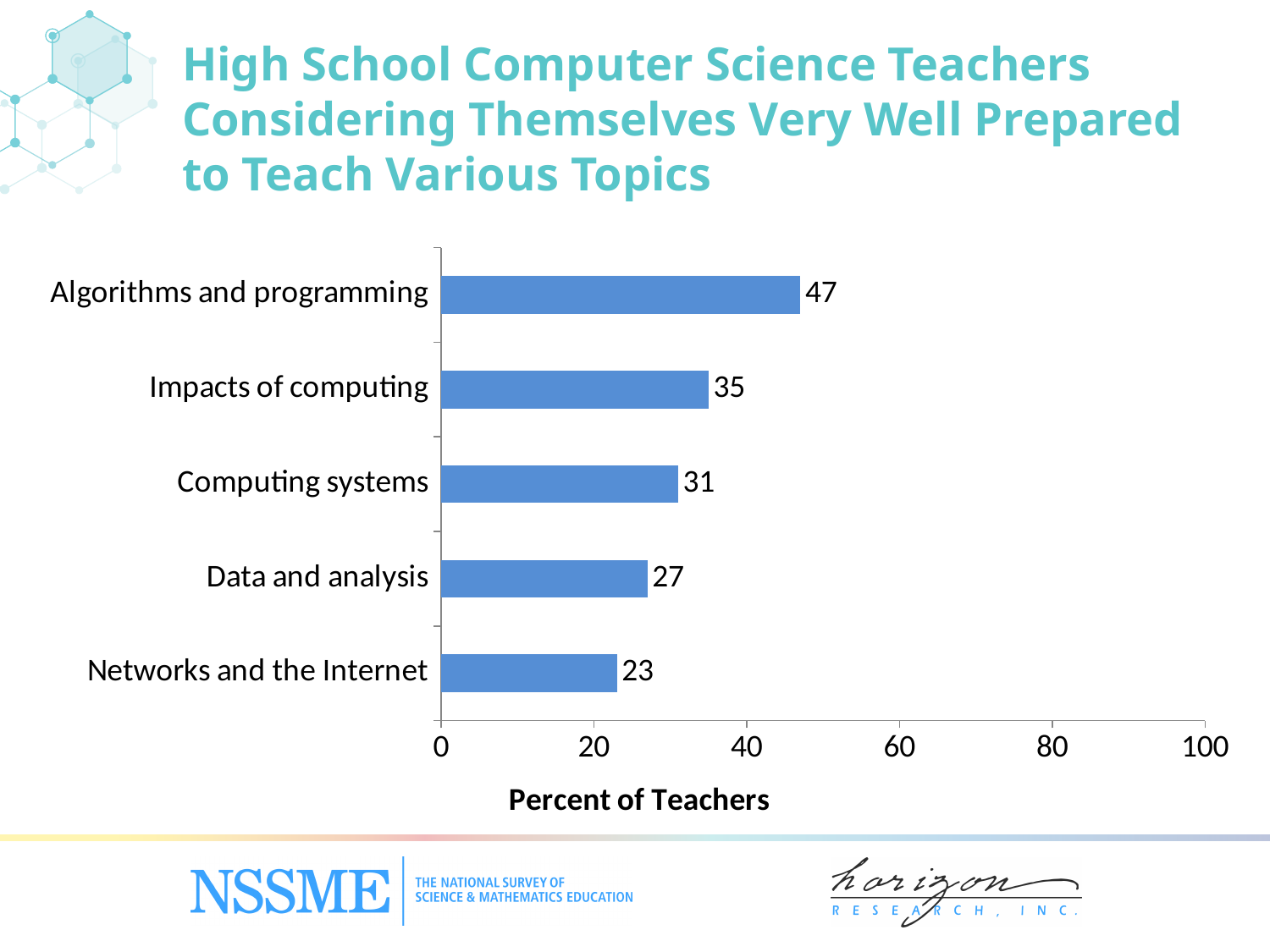
What is the value for Impacts of computing? 35 Is the value for Data and analysis greater or less than 40? less Which topic has the highest percent of teachers considering themselves very well prepared? Algorithms and programming What is the difference between the values for Algorithms and programming and Networks and the Internet? 24 What is the value for Networks and the Internet? 23 What is the label of the horizontal axis? Percent of Teachers What percent of teachers consider themselves very well prepared to teach Algorithms and programming? 47 What is the difference between the values for Computing systems and Data and analysis? 4 Which is larger, the value for Impacts of computing or the value for Computing systems? Impacts of computing What kind of chart is shown on the slide? bar chart How many topics are shown in the chart? 5 Which topic has the lowest percent of teachers considering themselves very well prepared? Networks and the Internet